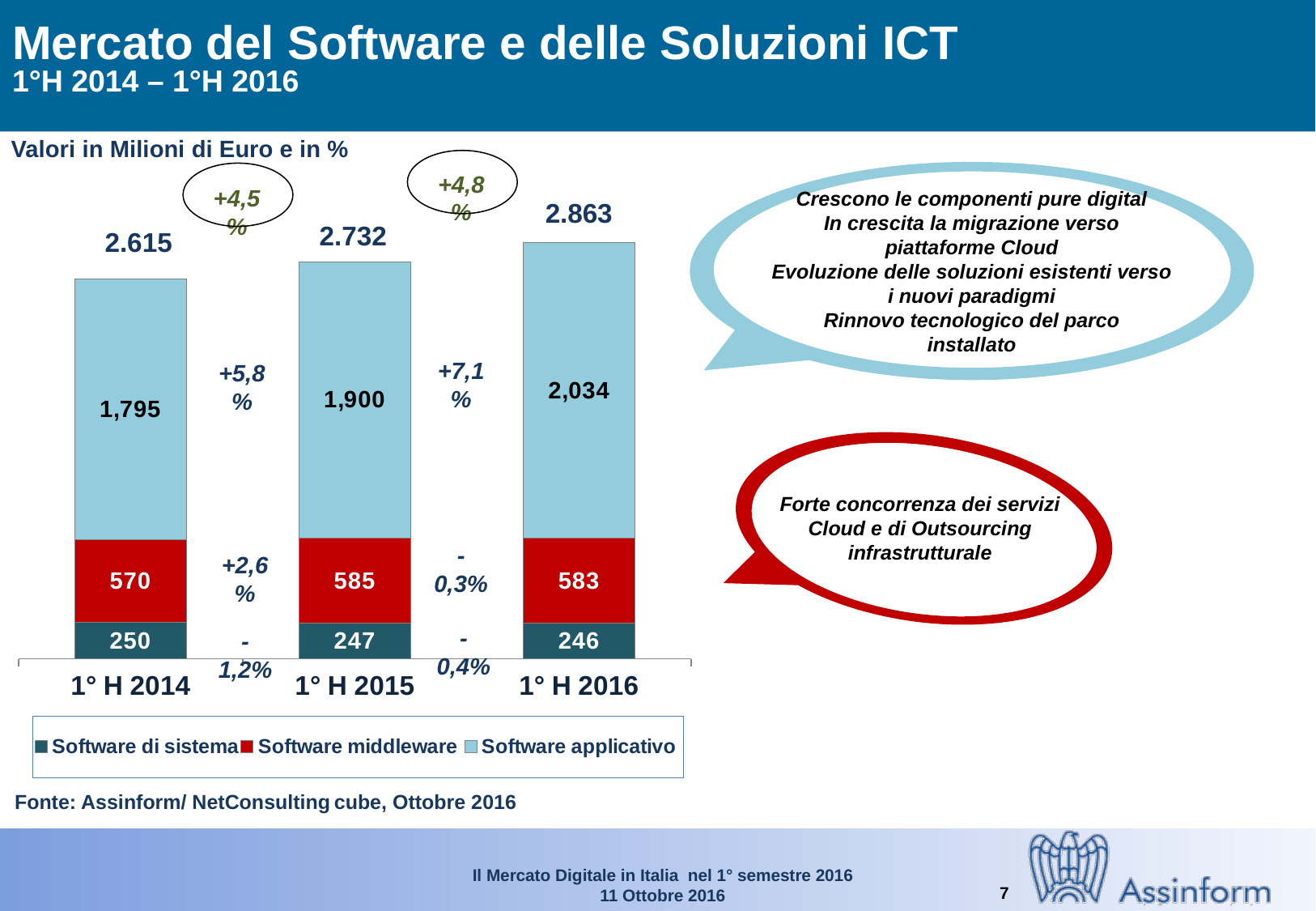
What percentage growth is shown for the total between 1° H 2015 and 1° H 2016? +4,8% What is the total shown above the stacked bar for 1° H 2015? 2.732 Which is larger: Software middleware in 1° H 2015 or in 1° H 2016? 1° H 2015 How many series does the legend list? 3 Which period has the highest total value? 1° H 2016 What is the difference between Software applicativo in 1° H 2016 and 1° H 2015? 134 How many periods are shown on the x axis? 3 What kind of chart is shown on the slide? Stacked bar chart Which period has the lowest value for Software applicativo? 1° H 2014 What is the value of Software middleware in 1° H 2015? 585 What is the value of Software applicativo in 1° H 2016? 2,034 What is the value of Software di sistema in 1° H 2014? 250